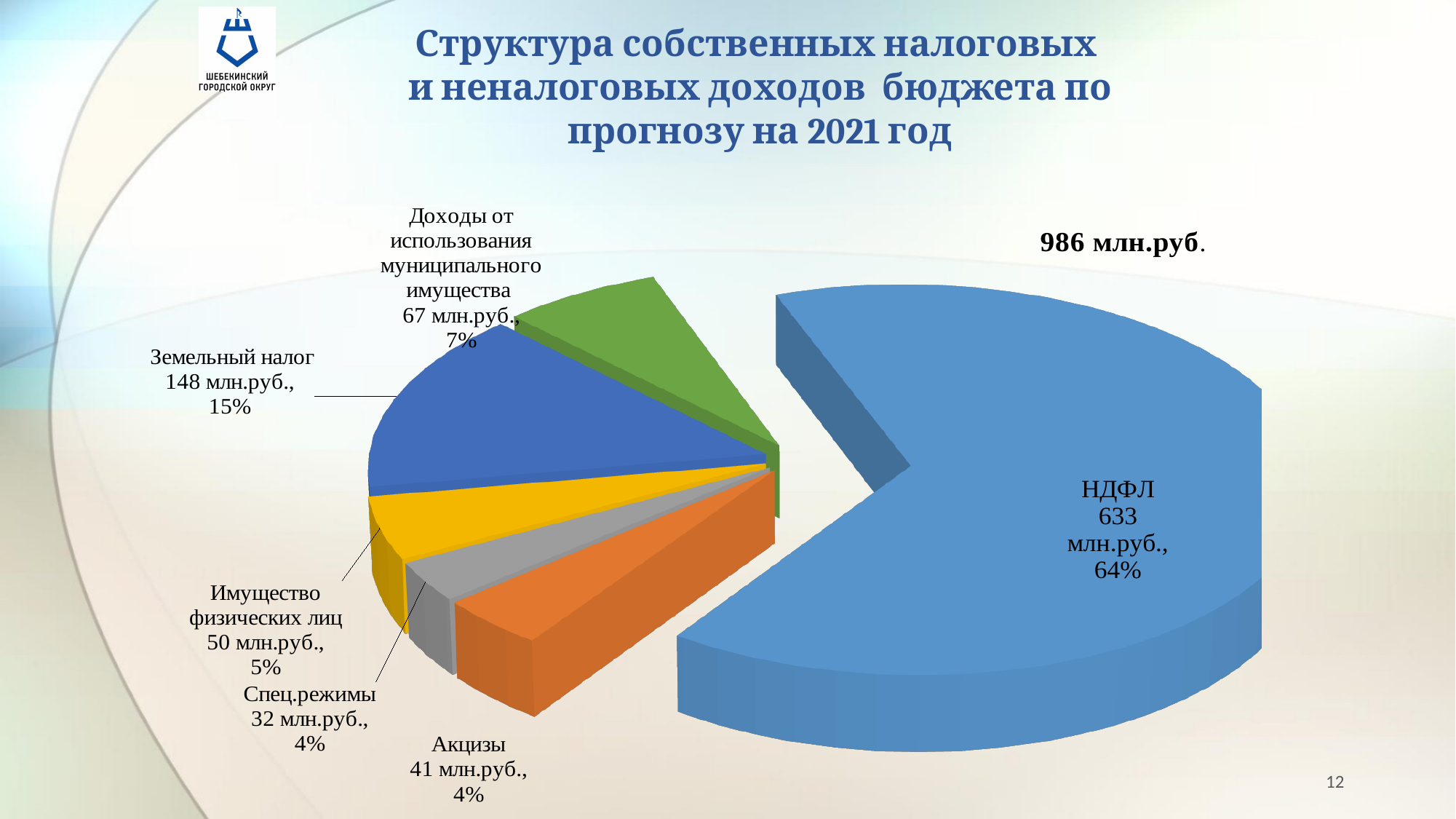
What share of the pie does Доходы от использования муниципального имущества represent? 7% What is the value for Акцизы? 41 млн.руб. What total amount is shown on the slide for the chart? 986 млн.руб. What share of the pie does НДФЛ represent? 64% Which category has the largest slice? НДФЛ What is the value for Земельный налог? 148 млн.руб. Which is larger, Акцизы or Спец.режимы? Акцизы Which category has the smallest value? Спец.режимы What is the value for НДФЛ? 633 млн.руб. How many slices does the pie chart have? 6 What kind of chart is shown on the slide? Pie chart What is the difference between Земельный налог and Имущество физических лиц? 98 млн.руб.